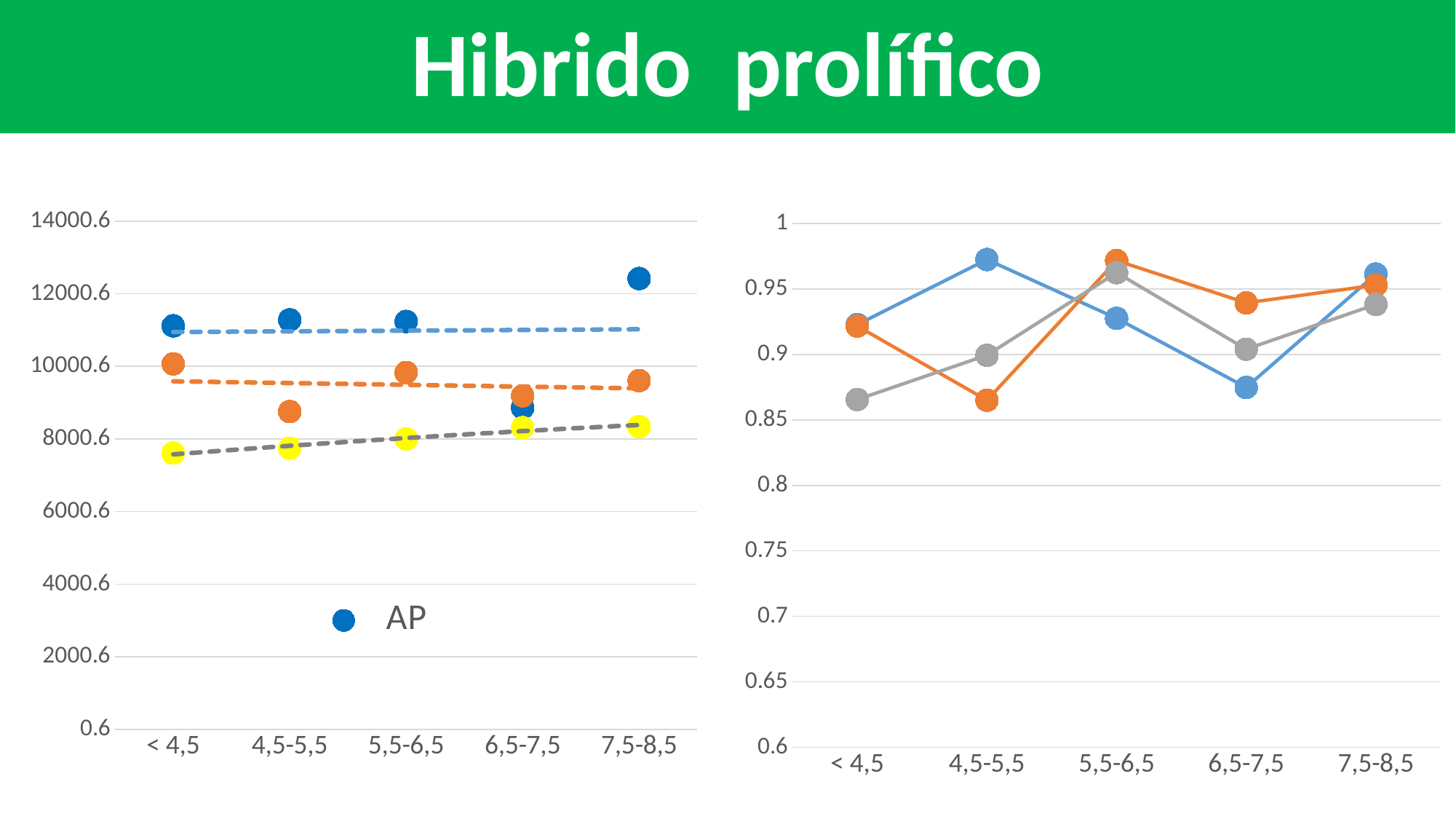
In the chart on the left side of the slide, is the blue point for 7,5-8,5 greater or less than 12000.6? greater In the chart on the right side of the slide, is the blue value for 6,5-7,5 greater or less than 0.9? less In the chart on the left side of the slide, at which category is the blue series highest? 7,5-8,5 In the chart on the left side of the slide, is the yellow point for < 4,5 greater or less than 8000.6? less In the chart on the right side of the slide, at which category is the gray series lowest? < 4,5 How many categories are shown on the x axis of the chart on the right side of the slide? 5 What type of chart is the chart on the right side of the slide? line chart In the chart on the right side of the slide, at 6,5-7,5, which is larger: the orange value or the blue value? orange How many categories are shown on the x axis of the chart on the left side of the slide? 5 In the chart on the left side of the slide, what series name is shown in the legend? AP